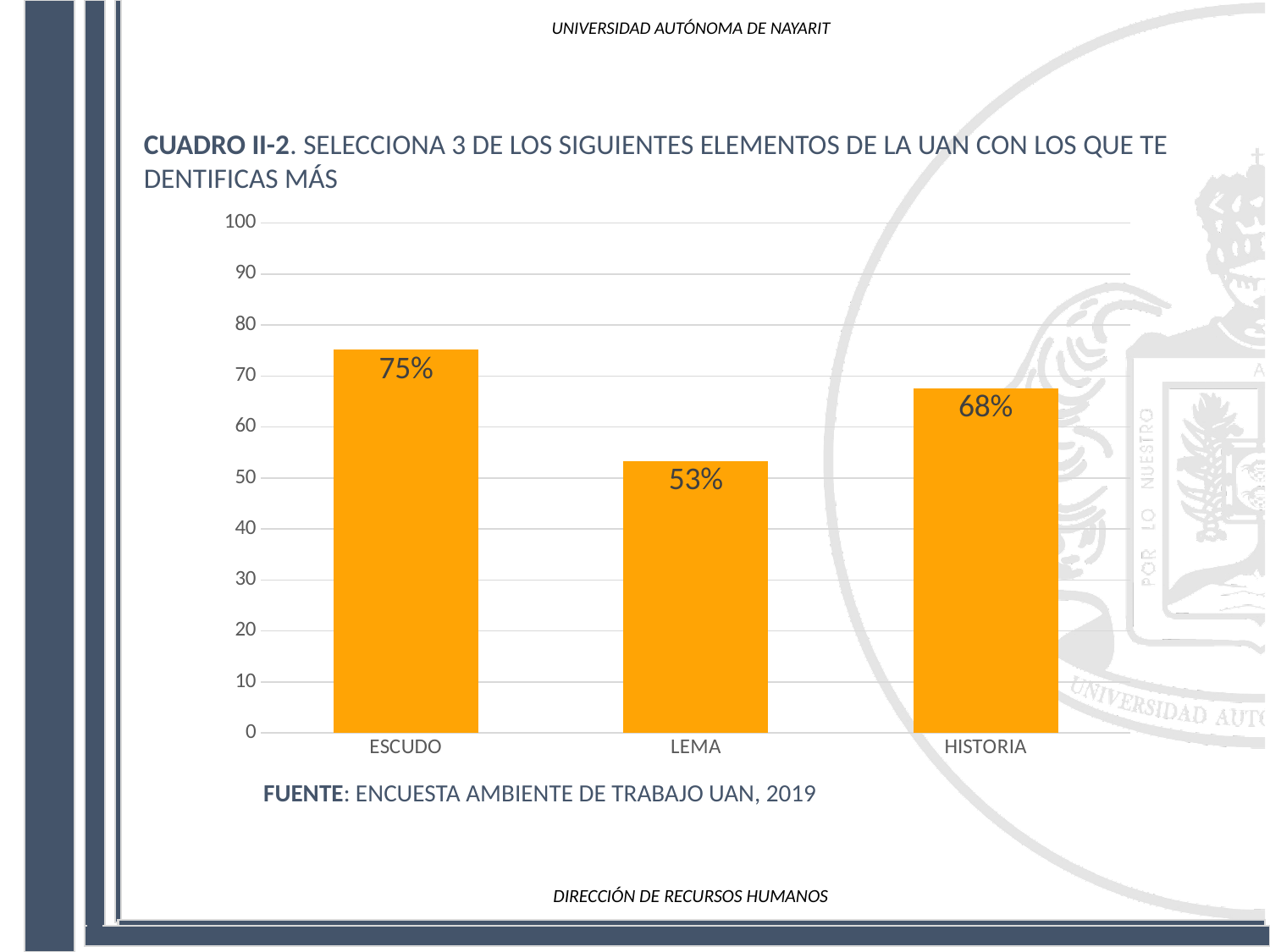
What is the difference between the values for ESCUDO and LEMA? 22% What is the difference between the values for ESCUDO and HISTORIA? 7% What is the value for HISTORIA? 68% Which category has the lowest value? LEMA Which is larger, the value for HISTORIA or the value for LEMA? HISTORIA Which category has the highest value? ESCUDO Is the value for LEMA greater or less than 60? less How many categories are shown in the chart? 3 What source is cited below the chart? ENCUESTA AMBIENTE DE TRABAJO UAN, 2019 What is the value for LEMA? 53% What kind of chart is shown on the slide? bar chart What is the value for ESCUDO? 75%